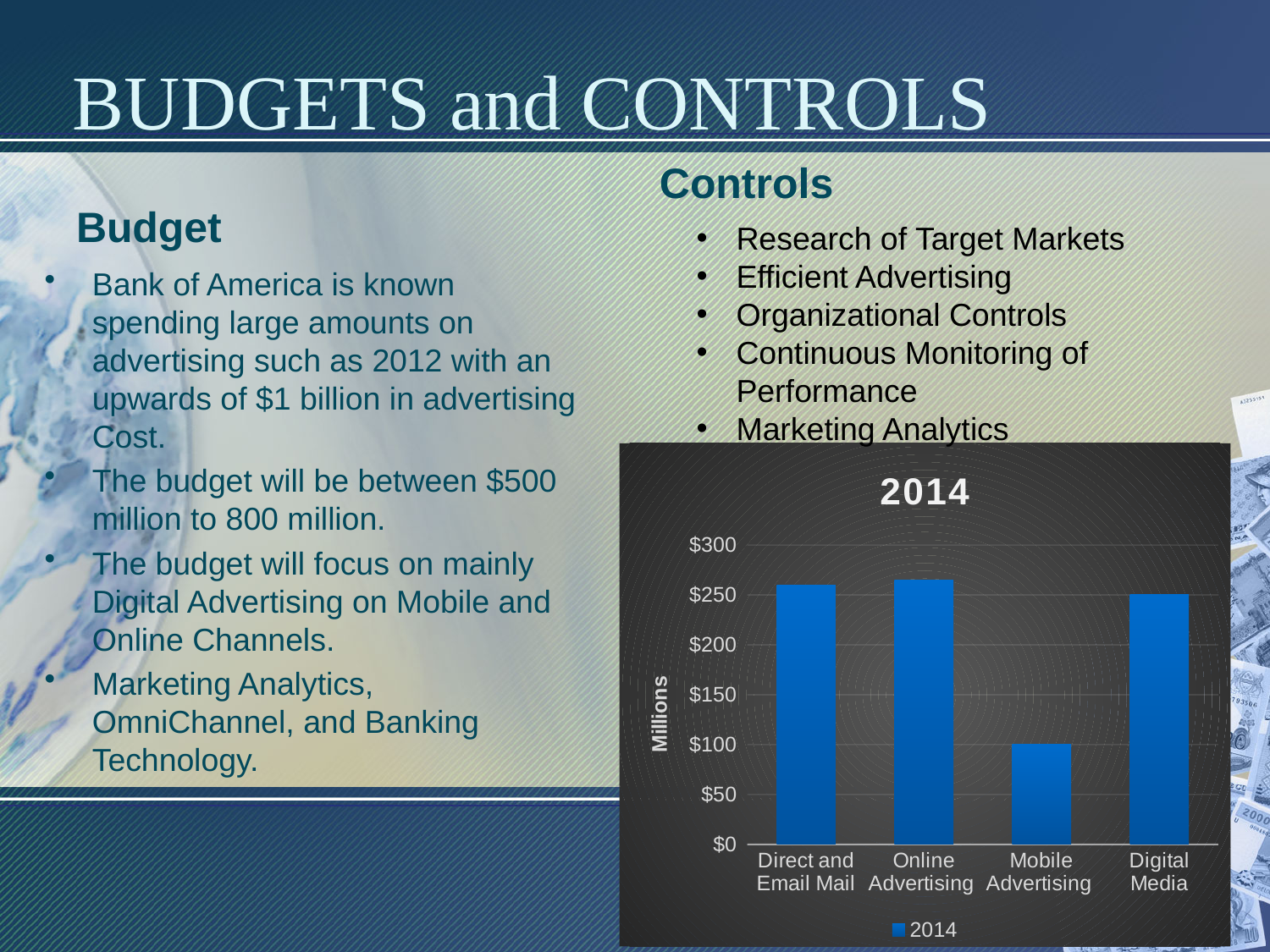
Which is larger, the value for Online Advertising or the value for Mobile Advertising? Online Advertising What is the title of the chart? 2014 Which category has the lowest value in the chart? Mobile Advertising How many series does the chart's legend list? 1 Is the value for Direct and Email Mail greater or less than $200? greater How many categories are shown on the x axis of the chart? 4 What kind of chart is shown on the slide? bar chart Which is larger, the value for Digital Media or the value for Mobile Advertising? Digital Media Is the value for Digital Media greater or less than $200? greater Is the value for Online Advertising greater or less than $250? greater What is the label on the vertical axis of the chart? Millions